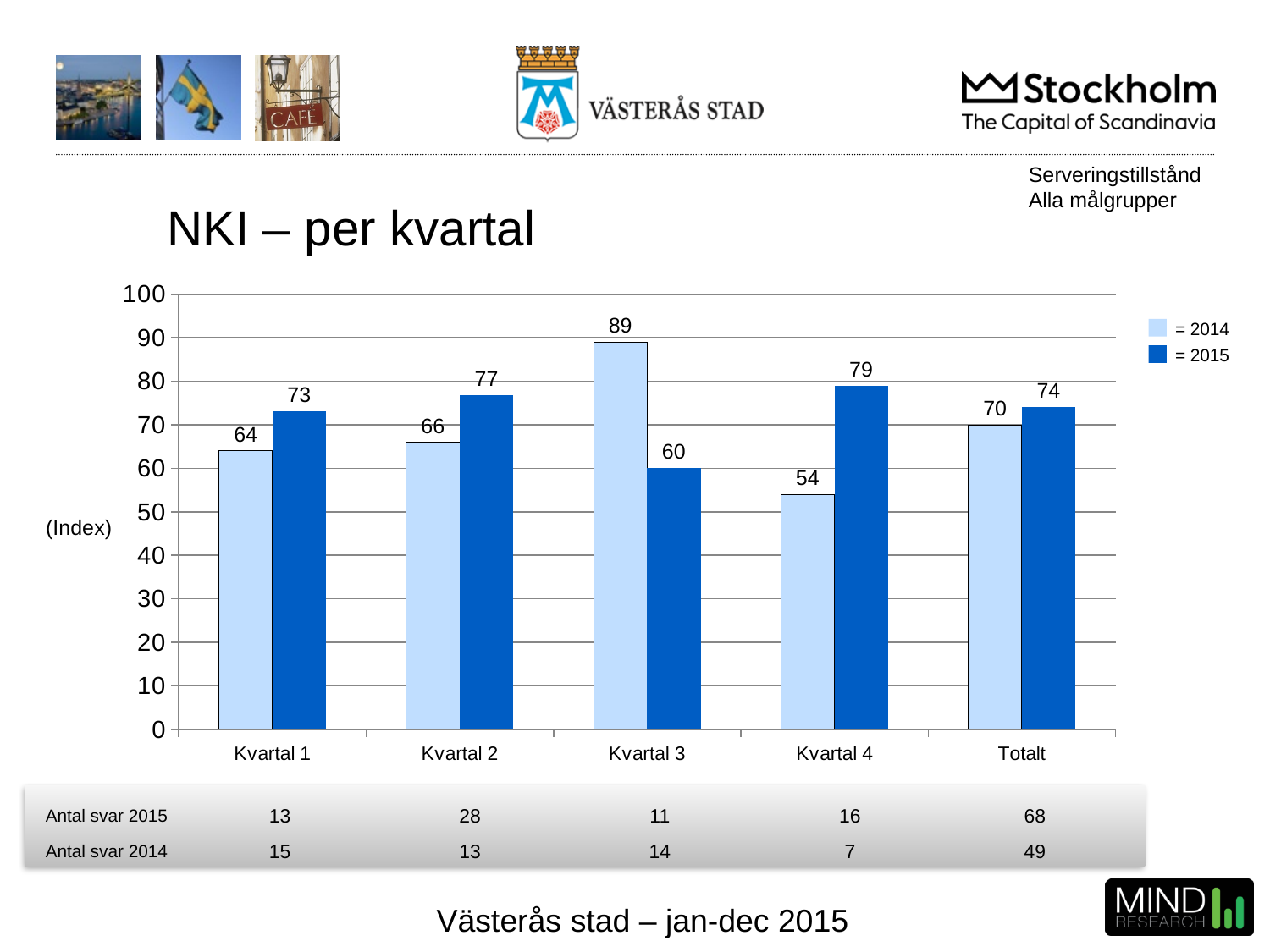
Which category has the highest 2014 value? Kvartal 3 What is the NKI value for Kvartal 4 in 2015? 79 Which category has the lowest 2015 value? Kvartal 3 What kind of chart is shown on the slide? bar chart What is the difference between the 2015 and 2014 values for Kvartal 4? 25 Is the 2014 value for Kvartal 1 greater or less than 70? less How many series does the legend list? 2 Which is larger for Kvartal 2: the 2014 value or the 2015 value? 2015 What is the NKI value for Kvartal 3 in 2014? 89 What is the title of the chart? NKI – per kvartal What is the Totalt NKI value for 2015? 74 How many categories are shown on the x axis? 5